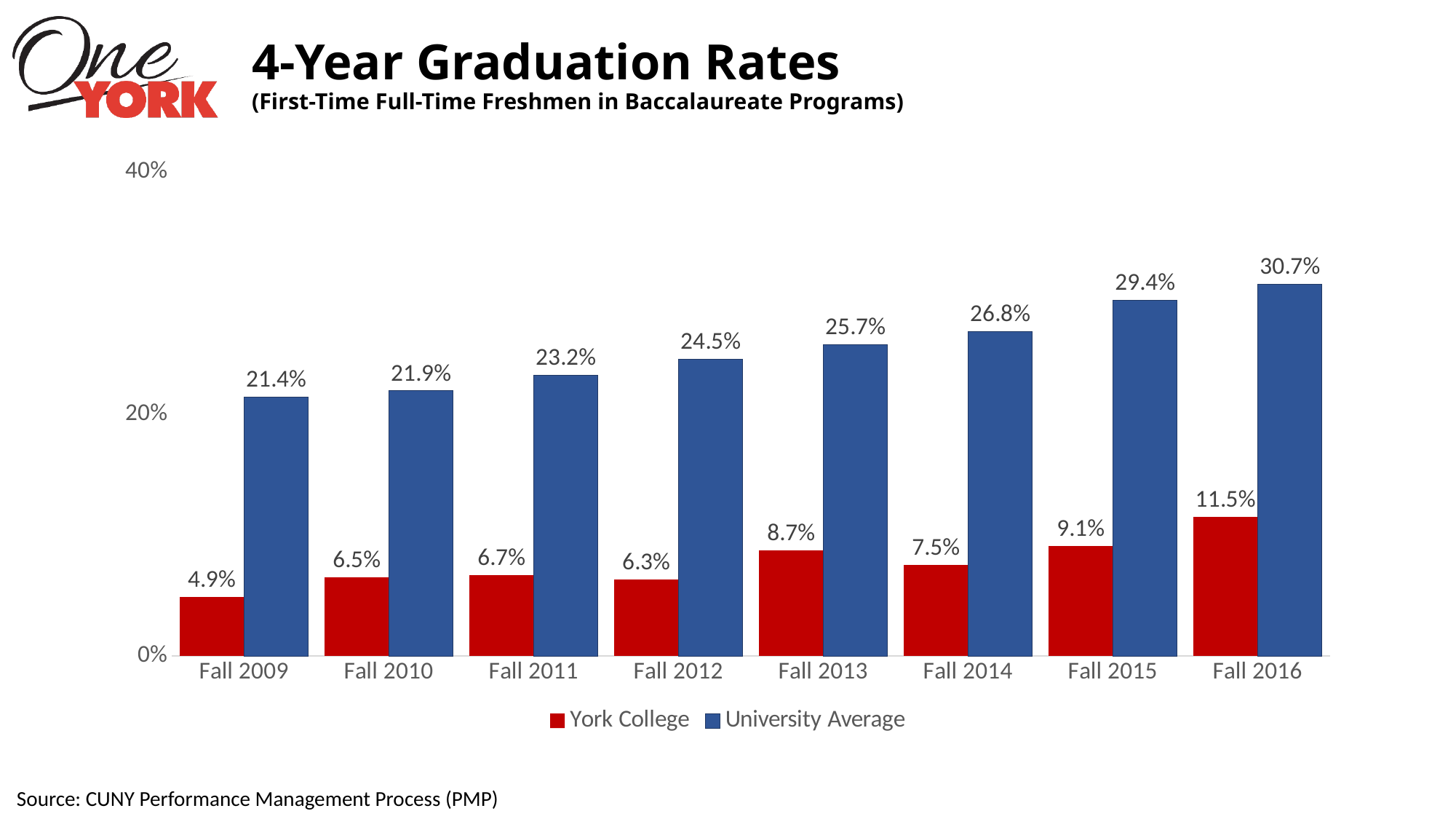
Which colour represents York College in the chart? Red In which year is the York College 4-year graduation rate lowest? Fall 2009 In which year is the University Average 4-year graduation rate highest? Fall 2016 How many series does the legend list? 2 Is the University Average value for Fall 2009 greater or less than 20%? greater How many years (categories) are shown on the x axis? 8 What kind of chart is shown on the slide? Bar chart What is the difference between the University Average and York College graduation rates in Fall 2016? 19.2% What is the 4-year graduation rate for York College in Fall 2016? 11.5% Does the University Average 4-year graduation rate rise or fall from Fall 2009 to Fall 2016? Rise What is the University Average 4-year graduation rate for Fall 2012? 24.5% Which is larger, the York College rate in Fall 2013 or in Fall 2014? Fall 2013